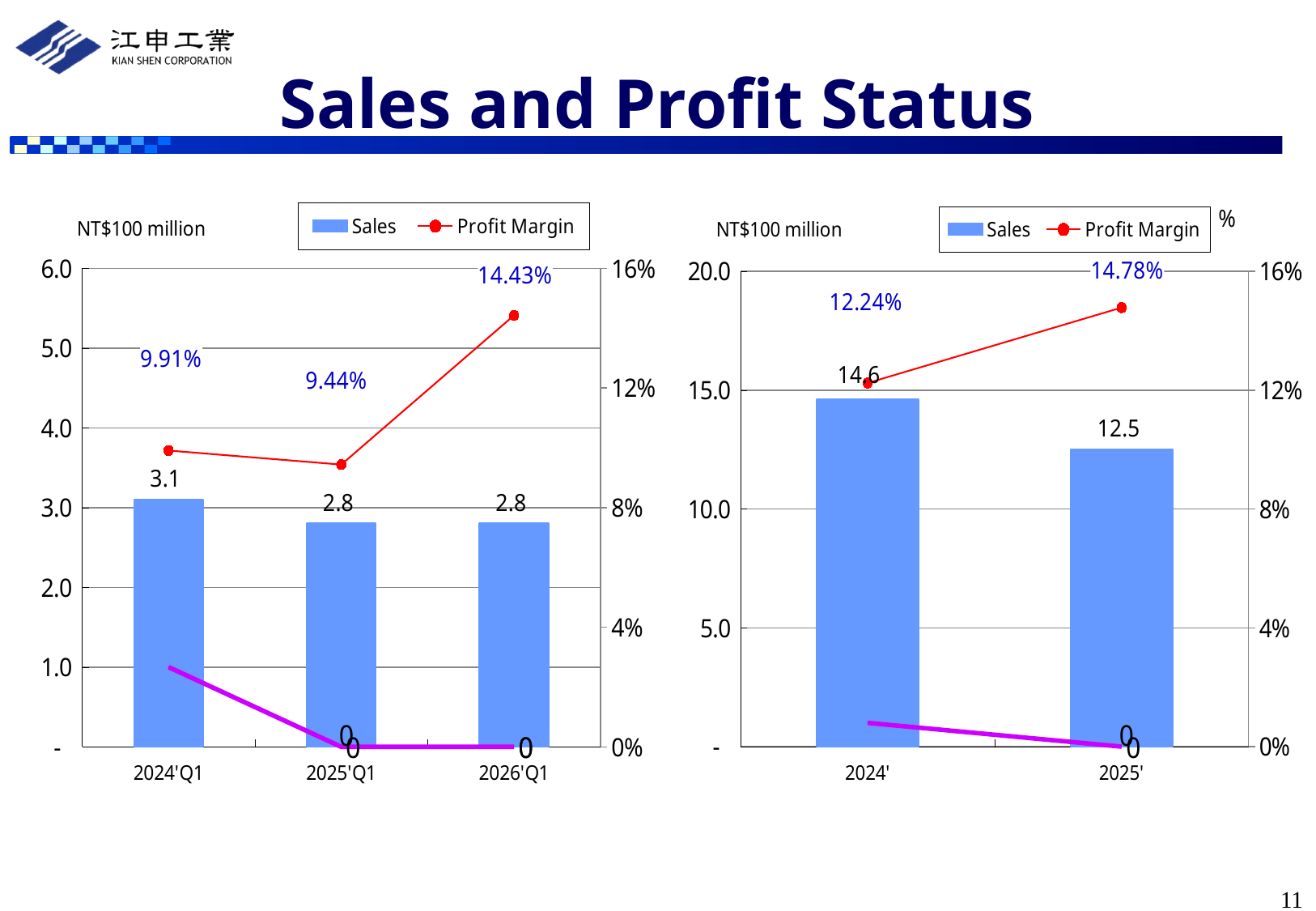
In the right chart, which year has the lower Sales value? 2025' In the left chart, what is the Sales value for 2024'Q1? 3.1 How many periods are shown on the x axis of the left chart? 3 How many series does the legend of the right chart list? 2 In the left chart, which period has the highest Profit Margin? 2026'Q1 In the left chart, what is the Profit Margin for 2025'Q1? 9.44% In the left chart, what is the Profit Margin for 2026'Q1? 14.43% In the right chart, what is the Profit Margin for 2024'? 12.24% In the right chart, what is the difference in Sales between 2024' and 2025'? 2.1 In the right chart, does the Profit Margin rise or fall from 2024' to 2025'? rise In the right chart, what is the Sales value for 2025'? 12.5 In the left chart, is the Sales value higher for 2024'Q1 or 2025'Q1? 2024'Q1